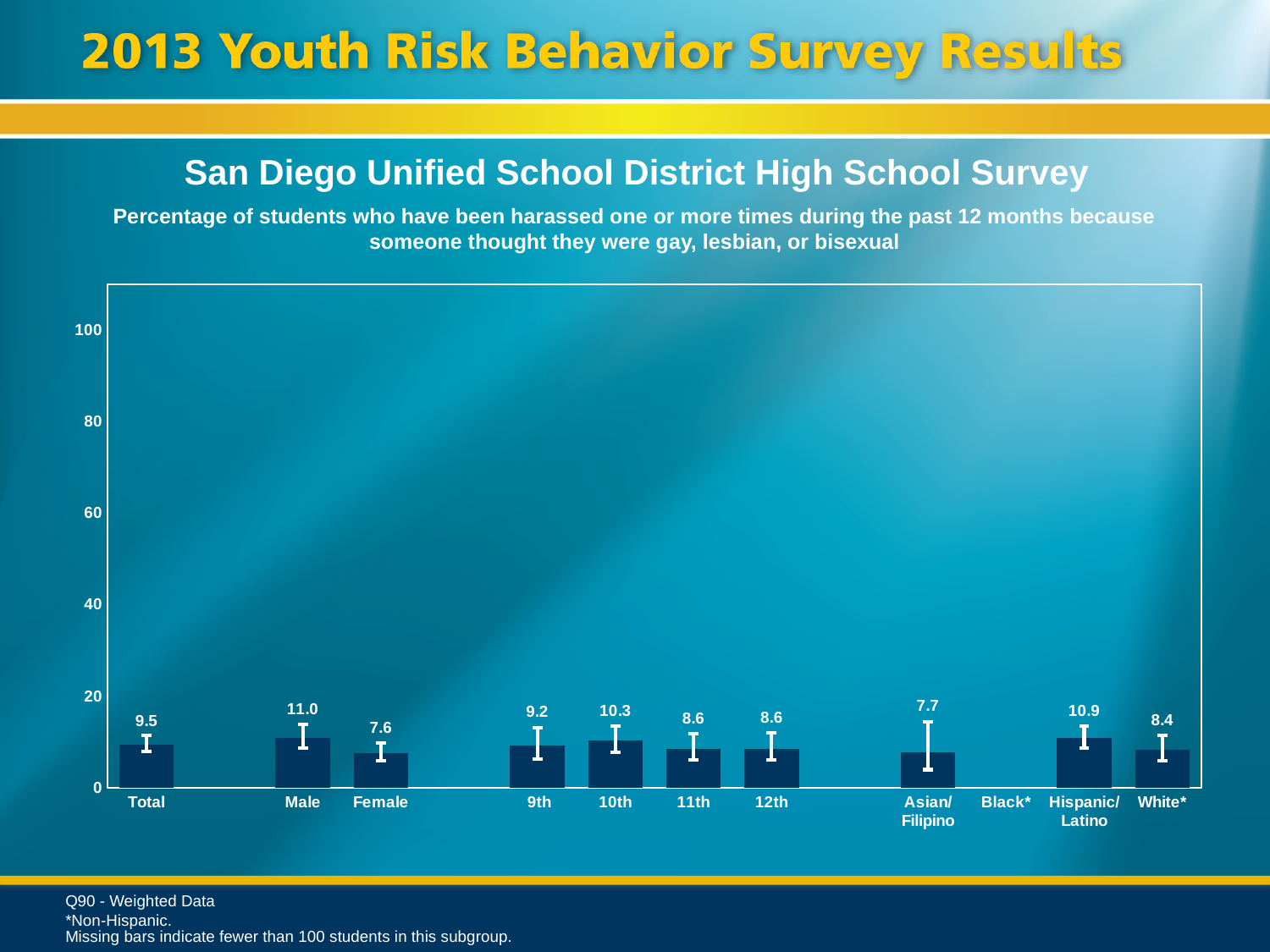
What is the value for Male? 11.0 What is the difference between the values for 10th and 9th grade? 1.1 What kind of chart is shown on the slide? bar chart Which is larger, the value for Male or the value for Female? Male What is the difference between the values for Male and Female? 3.4 What is the value for 10th grade? 10.3 What is the value for Asian/Filipino? 7.7 Is the value for Total greater or less than 20? less Which category on the x axis has no bar plotted? Black* What is the value for Hispanic/Latino? 10.9 What is the value for Female? 7.6 What is the value for Total? 9.5